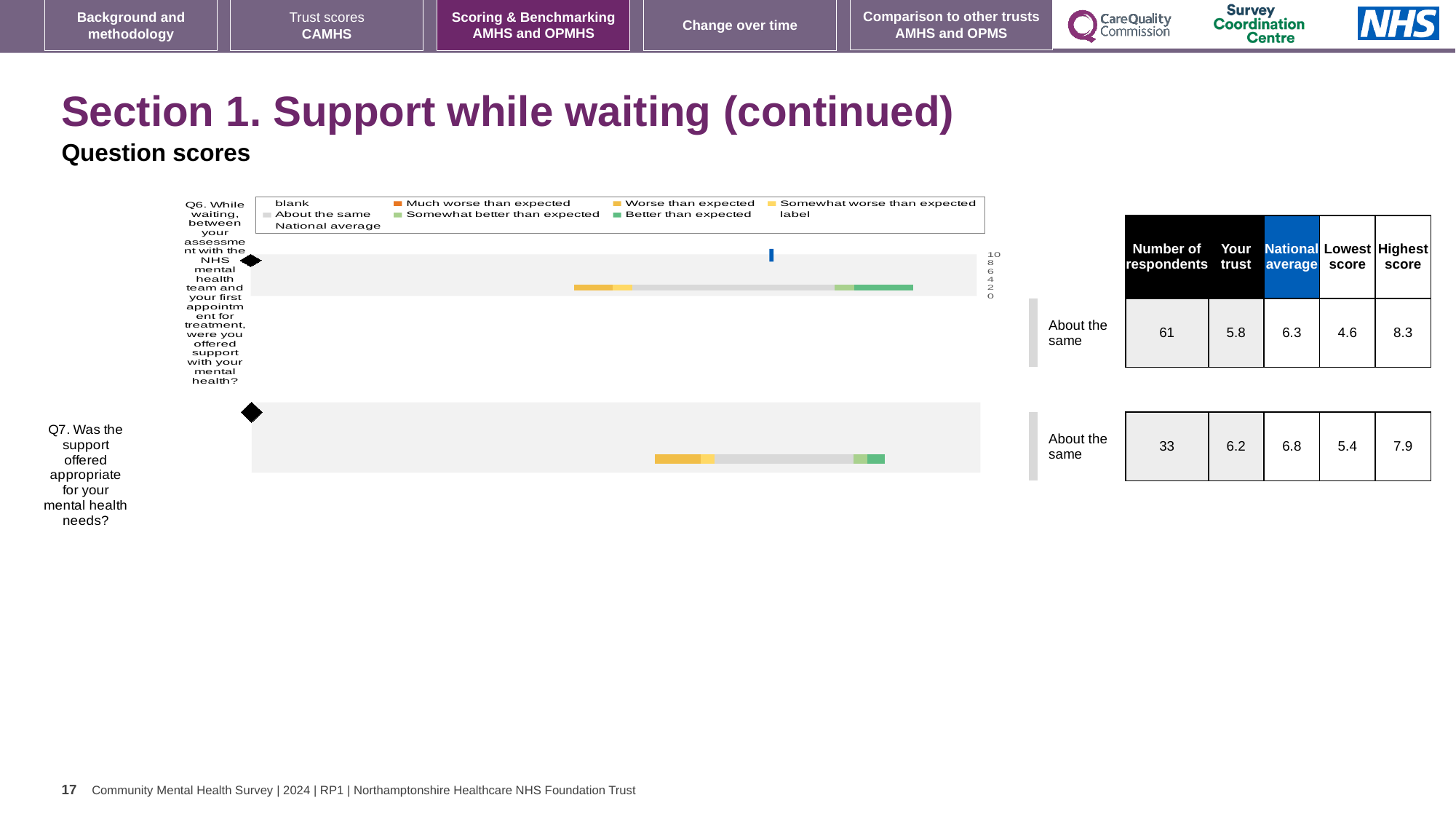
What is the difference between the highest score and the lowest score for Q6? 3.7 What is the lowest score shown for Q7? 5.4 How many questions (bars) are plotted on the slide? 2 Which question has the higher 'Your trust' score, Q6 or Q7? Q7 What colour represents 'Better than expected' in the legend? Green For Q6, how many respondents are shown in the table next to the chart? 61 For Q6, which is larger: the trust score or the national average? National average What is the difference between the highest score and the lowest score for Q7? 2.5 What kind of chart is used to show the question scores for Q6 and Q7? bar chart What benchmark category is shown for Q6? About the same What is the 'Your trust' score for Q6? 5.8 What is the national average score for Q7? 6.8